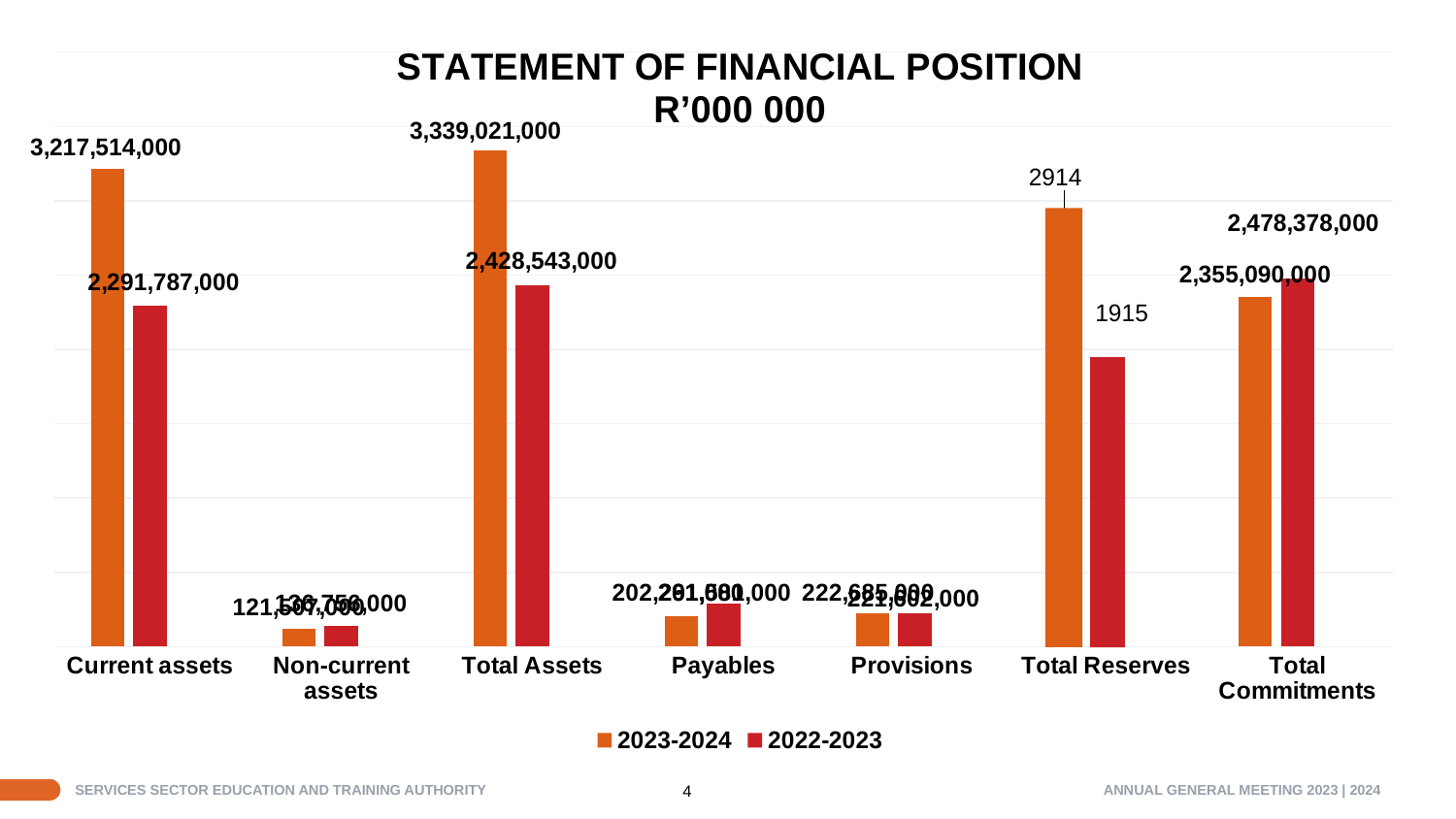
What is the difference between the 2023-2024 and 2022-2023 values for Total Reserves? 999 What is the difference between the 2023-2024 and 2022-2023 values for Current assets? 925,727,000 Which category has the lowest value in the 2022-2023 series? Non-current assets What is the value for Total Reserves in the 2023-2024 series? 2914 How many series does the legend list? 2 Which category has the highest value in the 2023-2024 series? Total Assets How many categories are shown on the x axis? 7 For Total Commitments, which series has the larger value, 2023-2024 or 2022-2023? 2022-2023 What kind of chart is shown on the slide? Bar chart What is the value for Total Assets in the 2022-2023 series? 2,428,543,000 What is the value for Current assets in the 2023-2024 series? 3,217,514,000 What is the value for Total Commitments in the 2022-2023 series? 2,478,378,000